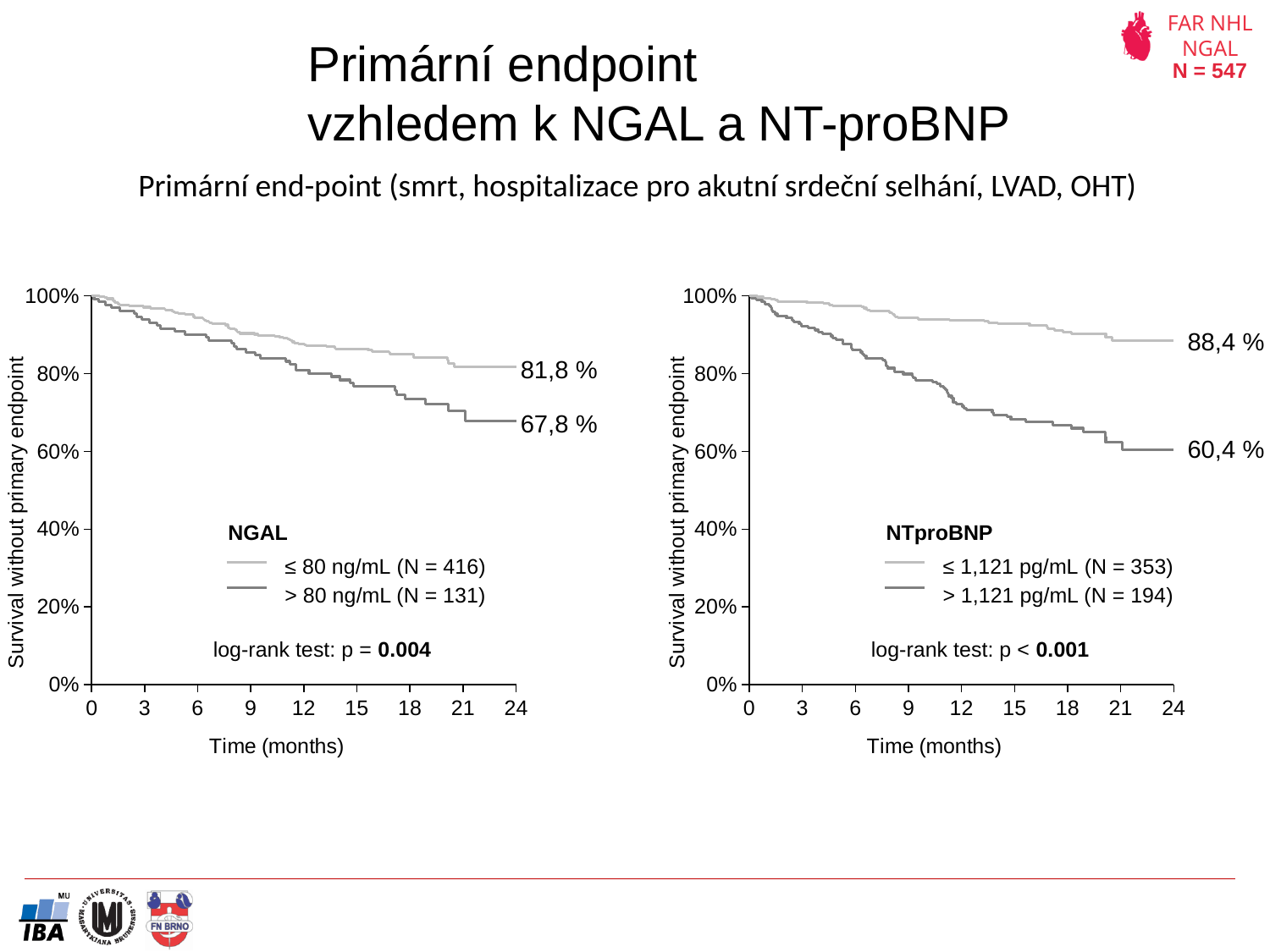
In the right chart (NTproBNP), what is the survival without primary endpoint at 24 months for the > 1,121 pg/mL group? 60,4 % How many groups does the legend of the left chart (NGAL) list? 2 In the right chart (NTproBNP), what is the survival without primary endpoint at 24 months for the ≤ 1,121 pg/mL group? 88,4 % In the right chart (NTproBNP), which group has the higher survival at 24 months? ≤ 1,121 pg/mL In the left chart (NGAL), what is the difference in 24-month survival between the ≤ 80 ng/mL and > 80 ng/mL groups? 14,0 % In the left chart (NGAL), what is the survival without primary endpoint at 24 months for the ≤ 80 ng/mL group? 81,8 % What is the log-rank test p value shown in the left chart (NGAL)? 0.004 In the right chart (NTproBNP), what is the difference in 24-month survival between the ≤ 1,121 pg/mL and > 1,121 pg/mL groups? 28,0 % In the right chart (NTproBNP), is the survival of the > 1,121 pg/mL group at 12 months greater or less than 80%? less In the left chart (NGAL), what is the survival without primary endpoint at 24 months for the > 80 ng/mL group? 67,8 % Do the survival curves in the right chart (NTproBNP) rise or fall over time? fall